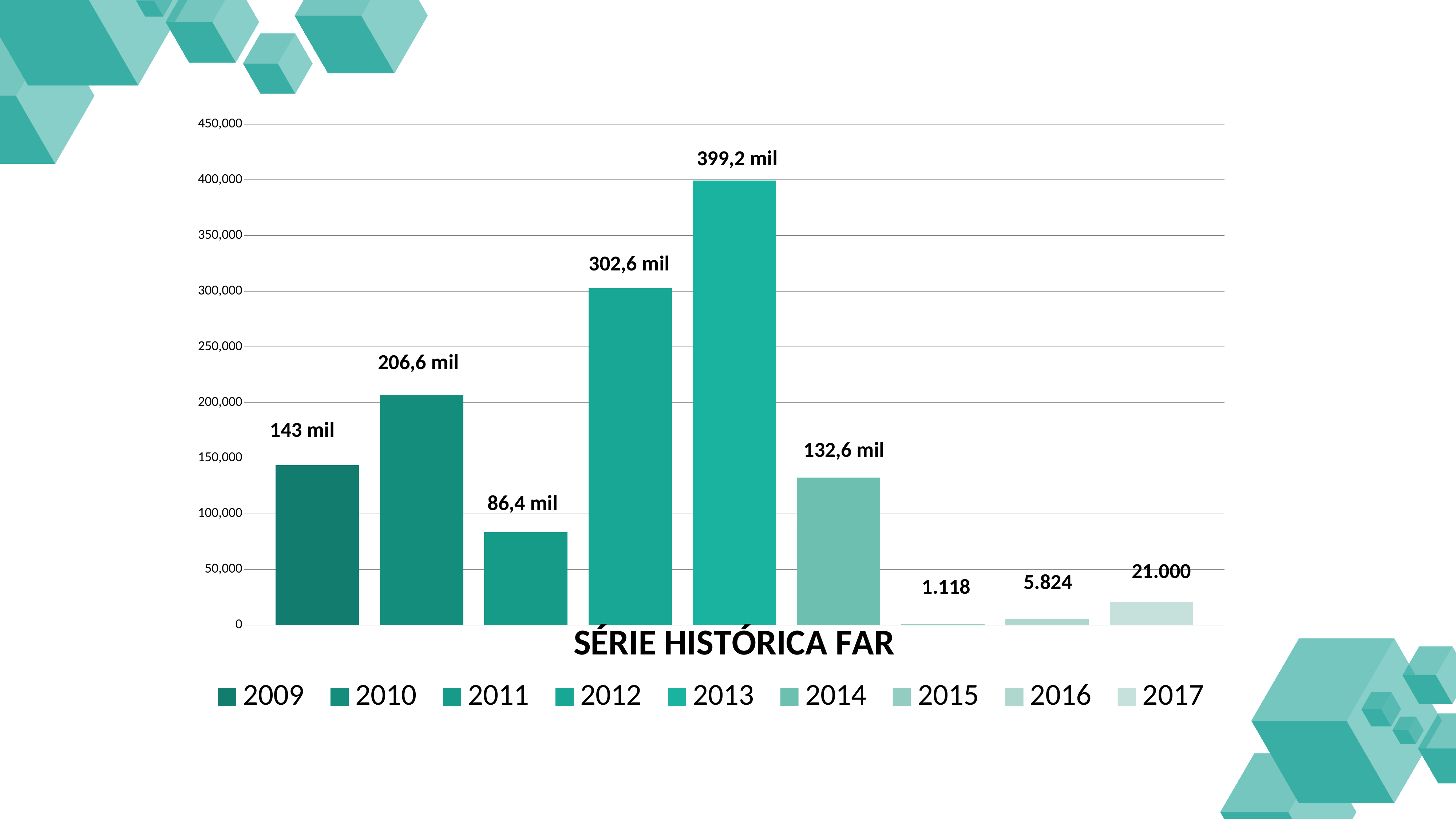
What is the value shown for 2017? 21.000 What is the value shown for 2013? 399,2 mil What is the title of the chart? SÉRIE HISTÓRICA FAR What is the difference between the values for 2013 and 2012? 96,6 mil What kind of chart is shown on the slide? bar chart Is the value for 2009 greater or less than 150,000? less Which year has the lowest value? 2015 Which is larger, the value for 2010 or the value for 2014? 2010 Which year has the highest value? 2013 What is the value shown for 2016? 5.824 How many entries does the legend list? 9 What is the value shown for 2011? 86,4 mil